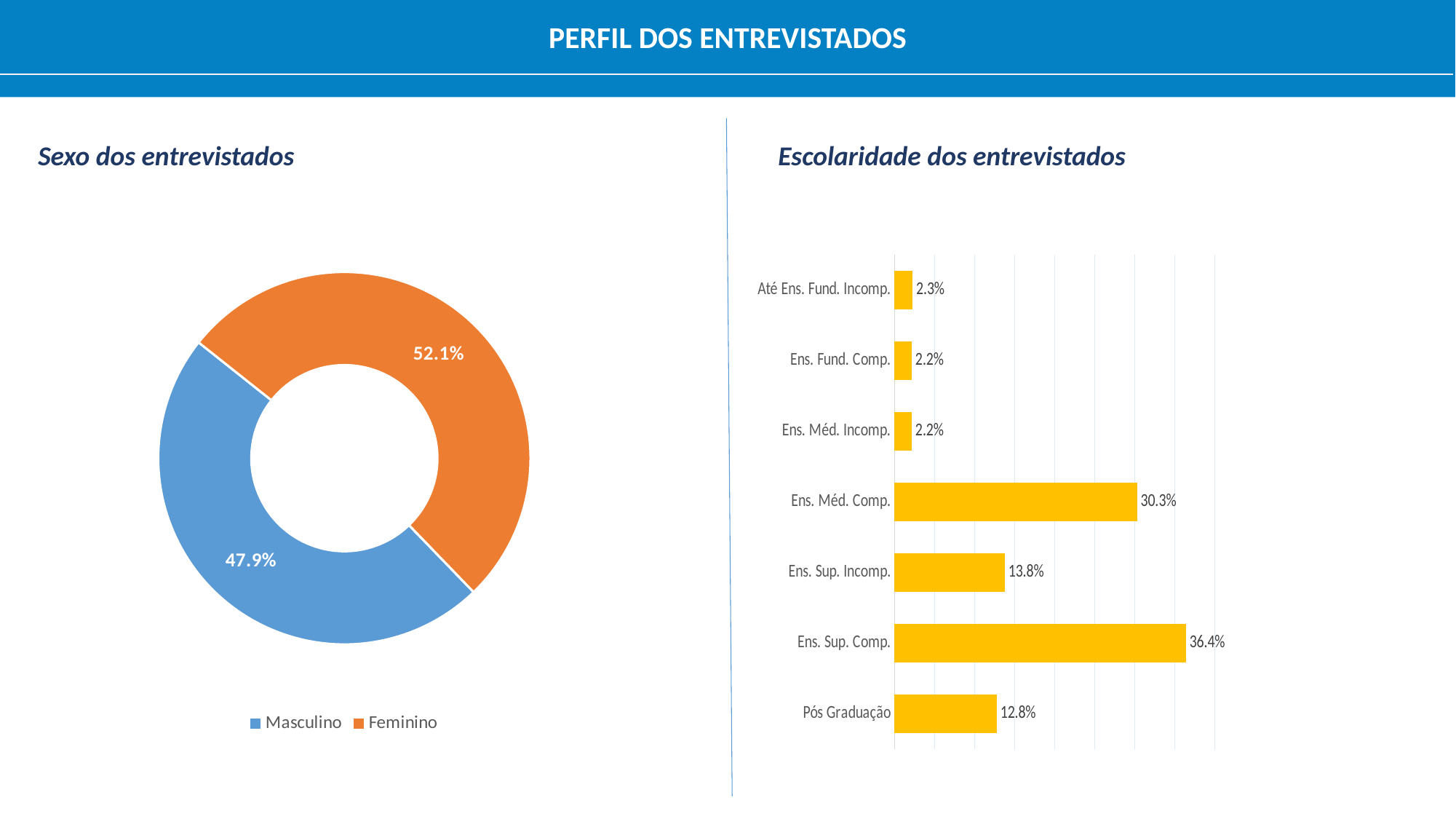
What kind of chart is 'Escolaridade dos entrevistados'? Bar chart In the 'Escolaridade dos entrevistados' chart, which category has the highest value? Ens. Sup. Comp. In the 'Escolaridade dos entrevistados' chart, what is the difference between Ens. Sup. Comp. and Ens. Méd. Comp.? 6.1% In the 'Escolaridade dos entrevistados' chart, what is the value for Ens. Sup. Comp.? 36.4% What kind of chart is 'Sexo dos entrevistados'? Doughnut (pie) chart In the 'Sexo dos entrevistados' chart, what percentage is Feminino? 52.1% In the 'Escolaridade dos entrevistados' chart, what is the value for Ens. Méd. Comp.? 30.3% In the 'Sexo dos entrevistados' chart, which category has the larger share? Feminino In the 'Escolaridade dos entrevistados' chart, how many categories are shown? 7 In the 'Sexo dos entrevistados' chart, what is the difference between the Feminino and Masculino shares? 4.2% How many entries does the legend of the 'Sexo dos entrevistados' chart list? 2 In the 'Sexo dos entrevistados' chart, what percentage is Masculino? 47.9%